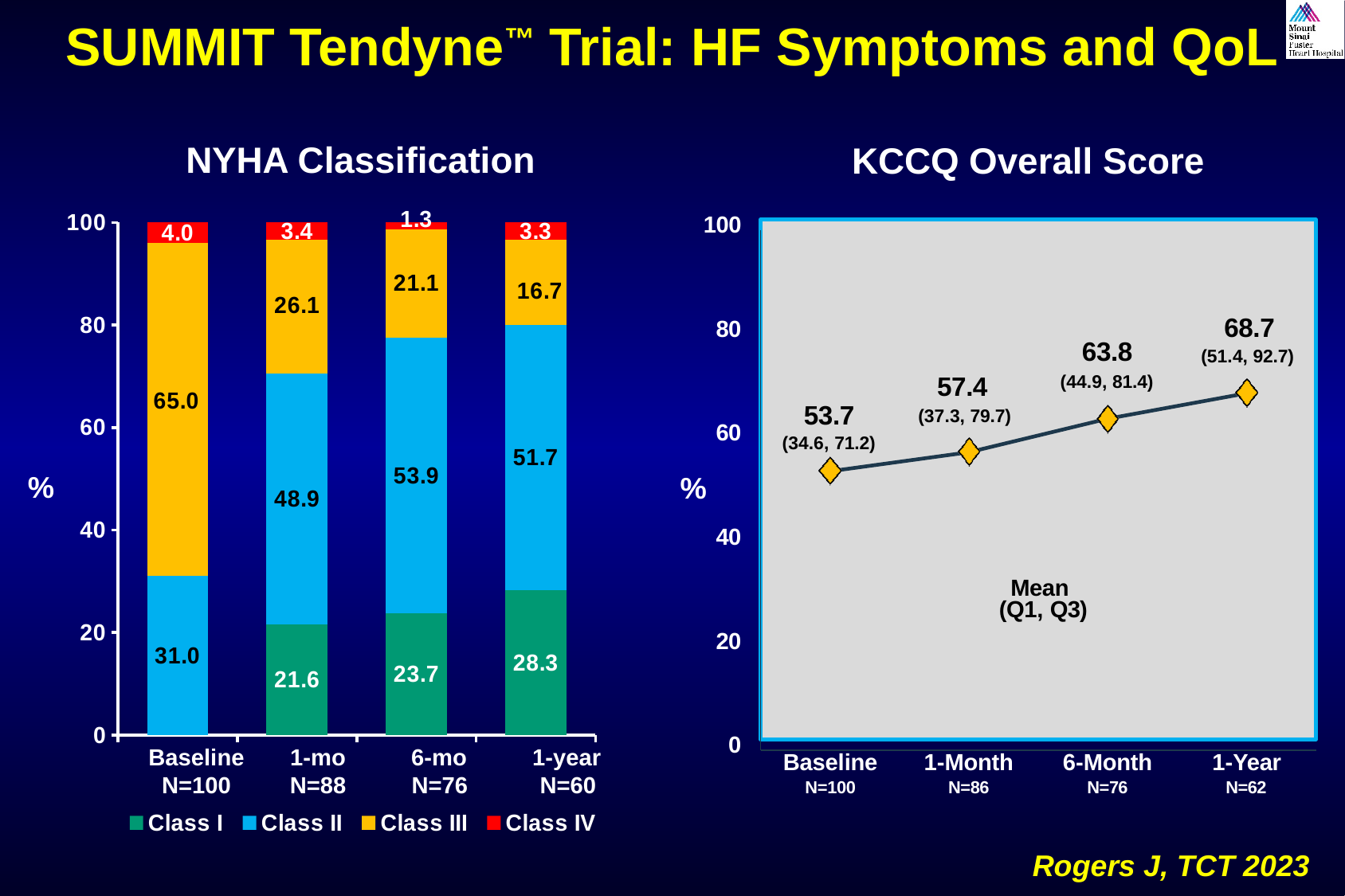
In the NYHA Classification chart, at which time point is the Class II share highest? 6-mo In the NYHA Classification chart, what percentage of patients were Class III at Baseline? 65.0 In the NYHA Classification chart, which is larger: Class I at 1-mo or Class I at 6-mo? Class I at 6-mo In the NYHA Classification chart, what is the difference between the Class III value at Baseline and at 1-year? 48.3 In the KCCQ Overall Score chart, what is the difference between the mean score at 1-Year and at Baseline? 15.0 How many series does the legend of the NYHA Classification chart list? 4 In the NYHA Classification chart, what is the Class I value at 1-year? 28.3 In the NYHA Classification chart, what is the Class IV value at 6-mo? 1.3 In the KCCQ Overall Score chart, what is the mean score at 6-Month? 63.8 What type of chart is the NYHA Classification chart? Stacked bar chart How many time points are plotted in the KCCQ Overall Score chart? 4 In the KCCQ Overall Score chart, do the mean scores rise or fall from Baseline to 1-Year? Rise